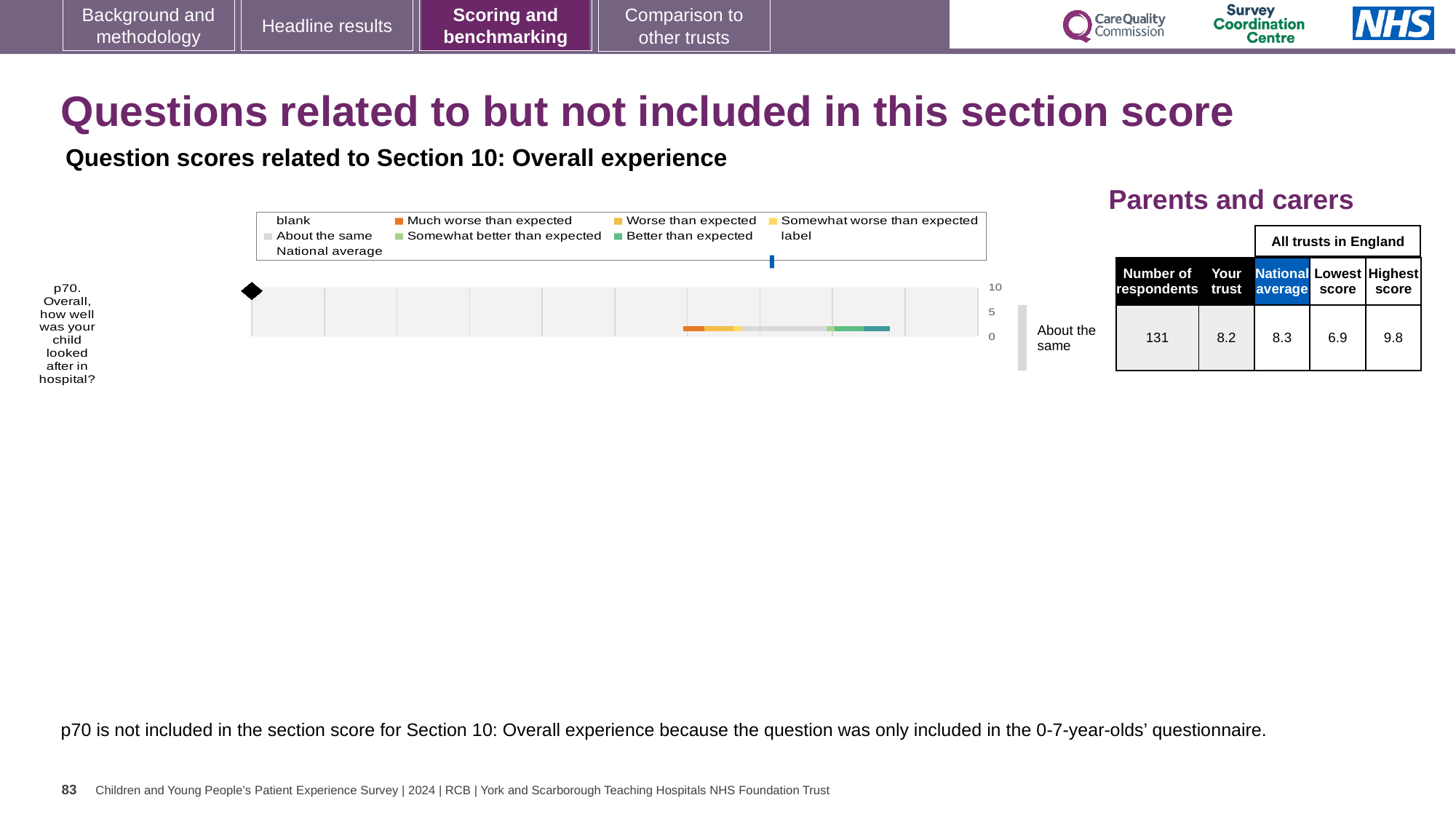
What is the difference between the highest and lowest trust scores for p70? 2.9 What is the difference between the national average and the 'Your trust' score for p70? 0.1 What is the national average score for p70? 8.3 What kind of chart is used to show the p70 question score? bar chart What is the 'Your trust' score for p70 in the table next to the chart? 8.2 How many respondents answered p70? 131 What is the lowest score among all trusts in England for p70? 6.9 How many questions are plotted in the chart? 1 What colour represents 'Much worse than expected' in the chart legend? Orange What is the highest score among all trusts in England for p70? 9.8 What category label is shown to the right of the p70 bar? About the same Which is larger for p70, the 'Your trust' score or the national average? National average